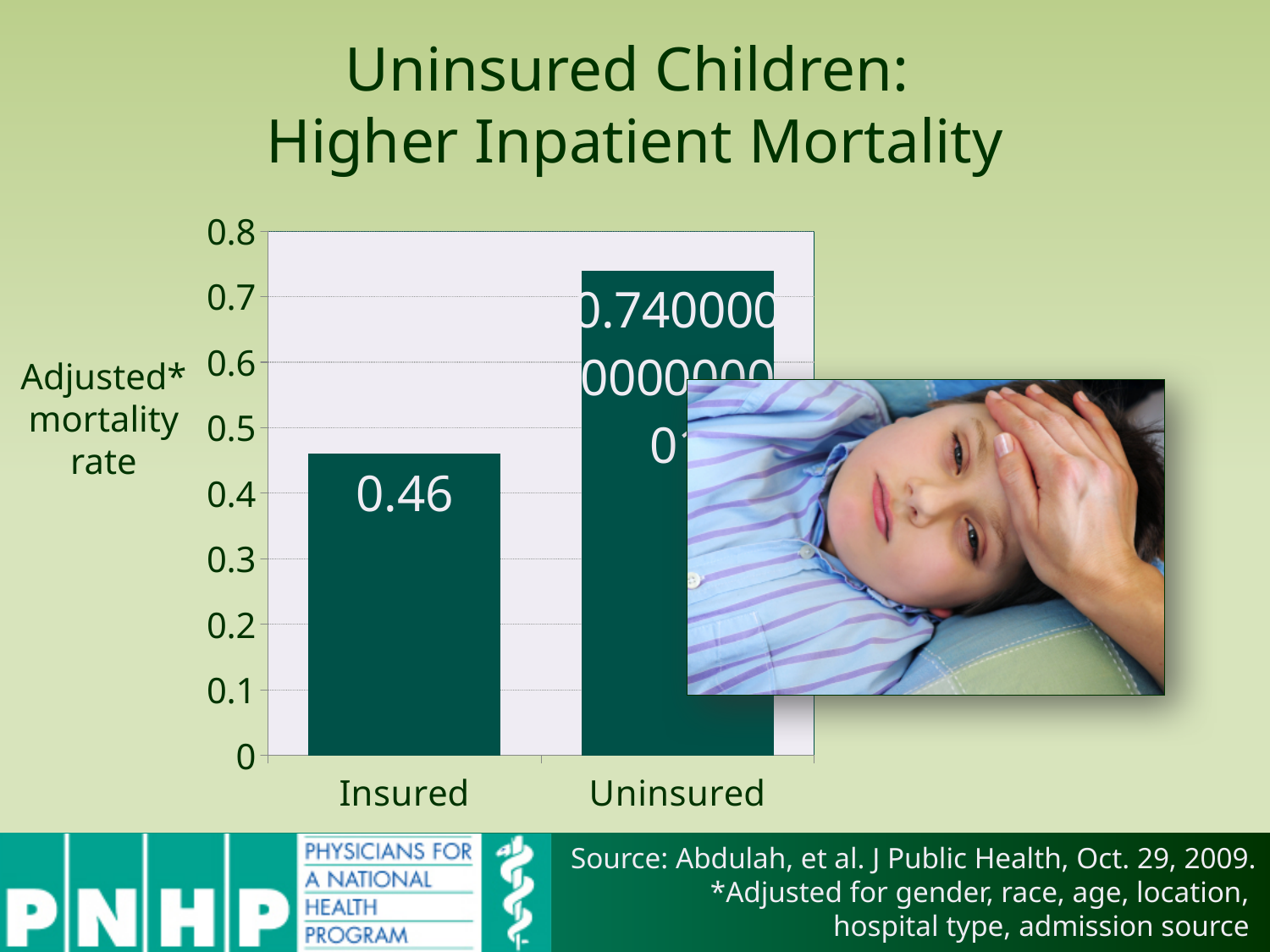
What kind of chart is shown on the slide? Bar chart What is the label on the vertical axis of the chart? Adjusted* mortality rate What is the highest value shown on the vertical axis? 0.8 Do the values rise or fall going from Insured to Uninsured? Rise What is the adjusted mortality rate for Insured children? 0.46 Which category has the lower adjusted mortality rate? Insured Is the value for Uninsured greater or less than 0.7? greater Which is larger, the mortality rate for Insured or for Uninsured children? Uninsured Is the value for Insured greater or less than 0.5? less Is the value for Insured greater or less than 0.4? greater Which category has the higher adjusted mortality rate? Uninsured How many categories are shown on the x axis of the chart? 2